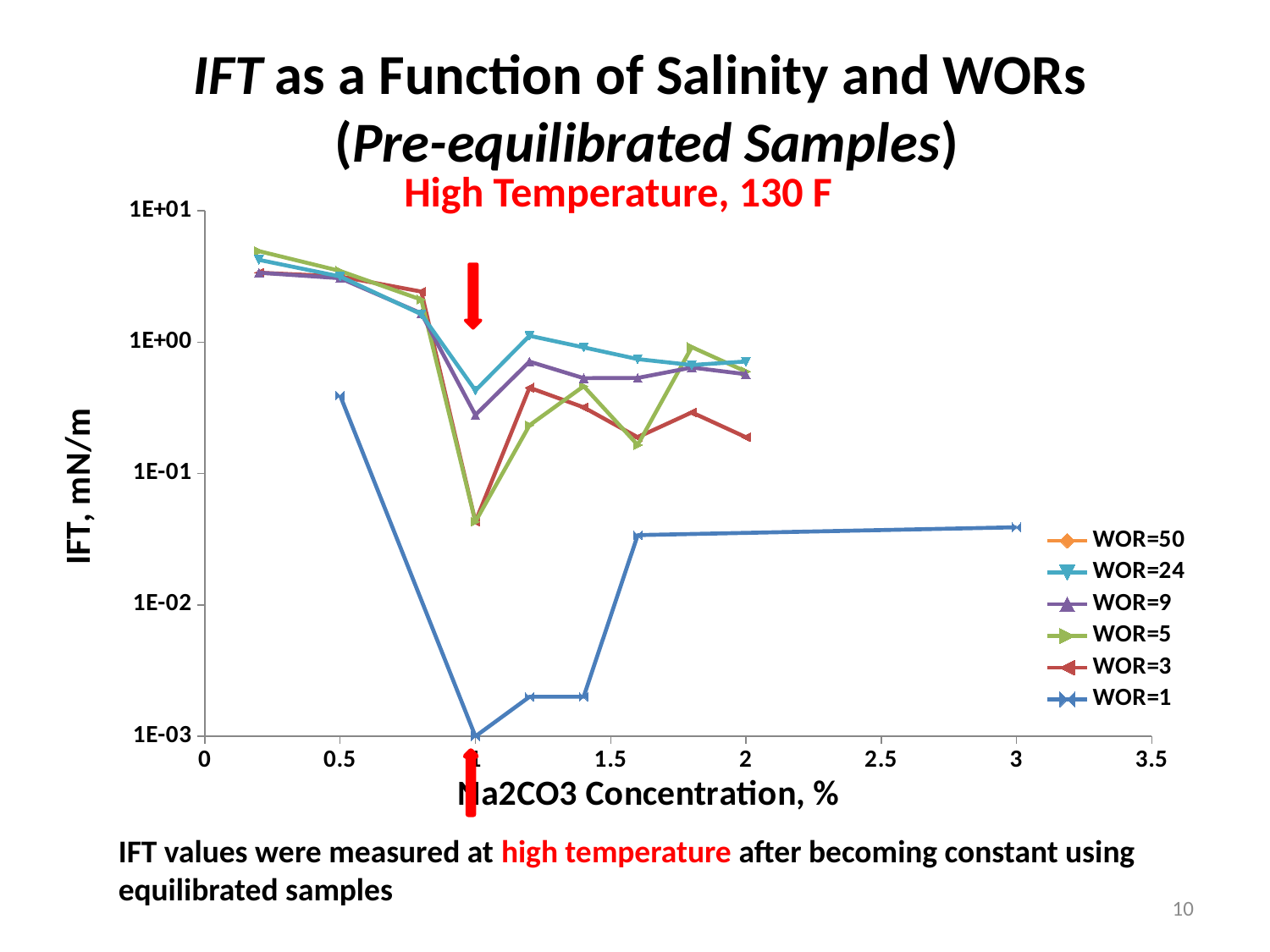
Is the IFT value for WOR=24 at a Na2CO3 concentration of 0.2% greater or less than 1E+00? greater Is the IFT value for WOR=1 at a Na2CO3 concentration of 1% greater or less than 1E-02? less Is the IFT value for WOR=5 at a Na2CO3 concentration of 1% greater or less than 1E-01? less Which series has the lowest IFT value at a Na2CO3 concentration of 1%? WOR=1 What is the label of the x axis? Na2CO3 Concentration, % What kind of chart is shown on the slide? line chart Does the IFT value for WOR=24 rise or fall as the Na2CO3 concentration increases from 0.2% to 1%? fall At a Na2CO3 concentration of 1%, which series has the larger IFT value, WOR=24 or WOR=5? WOR=24 How many series does the legend list? 6 What is the label of the y axis? IFT, mN/m How many data points are plotted for the WOR=1 series? 6